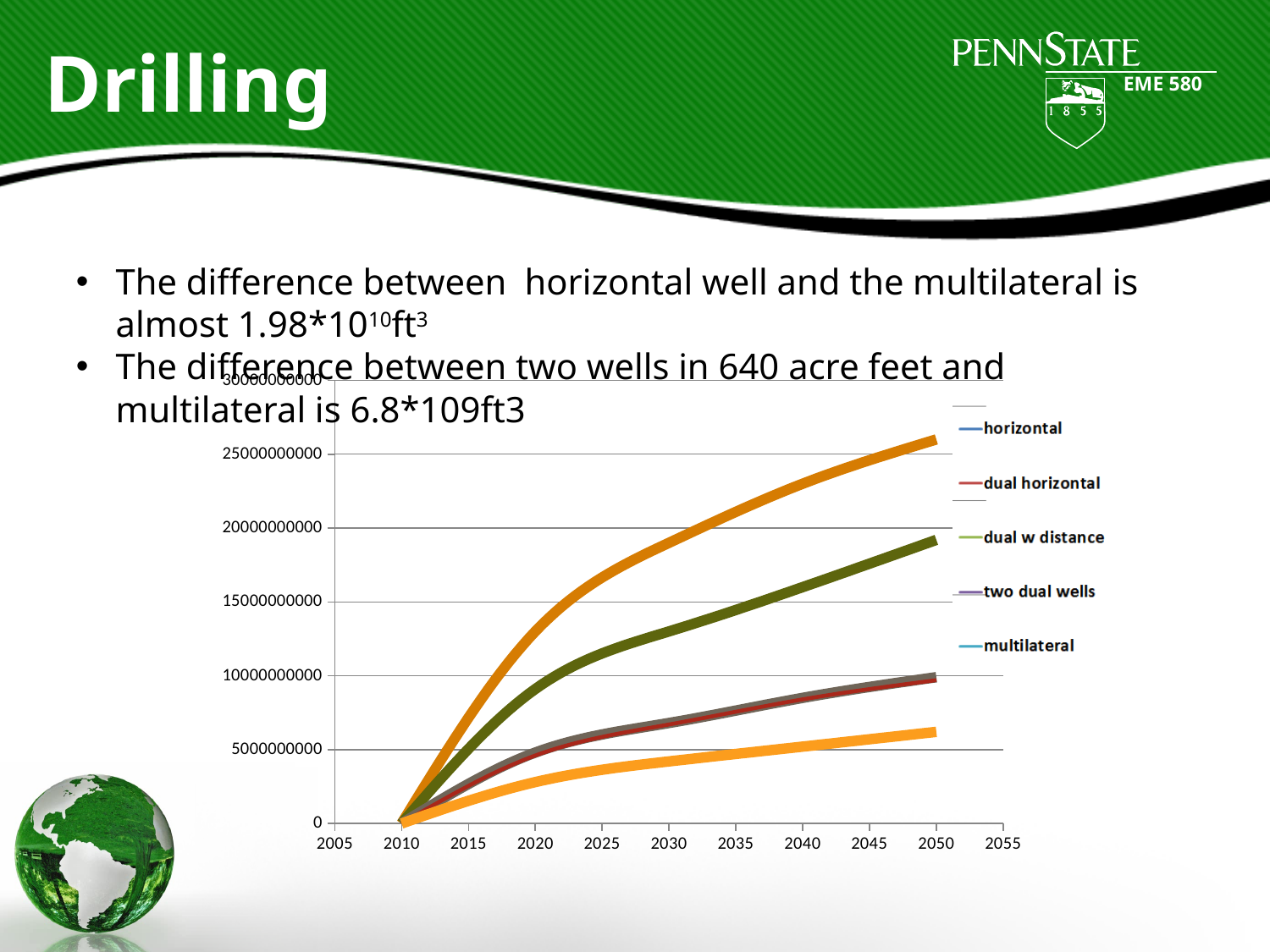
In which year do all the plotted lines start? 2010 What is the last year label on the chart's horizontal axis? 2055 What is the last series listed in the chart's legend? multilateral How many year labels are shown on the chart's horizontal axis? 11 What is the highest value shown on the chart's vertical axis? 30000000000 Is the value of the topmost line in 2050 greater or less than 25000000000? greater How many series does the chart's legend list? 5 Is the value of the lowest line in 2050 greater or less than 5000000000? greater What kind of chart is shown on the slide? line chart Do the plotted lines rise or fall as the year increases from 2010 to 2050? rise What is the first year label on the chart's horizontal axis? 2005 What is the first series listed in the chart's legend? horizontal